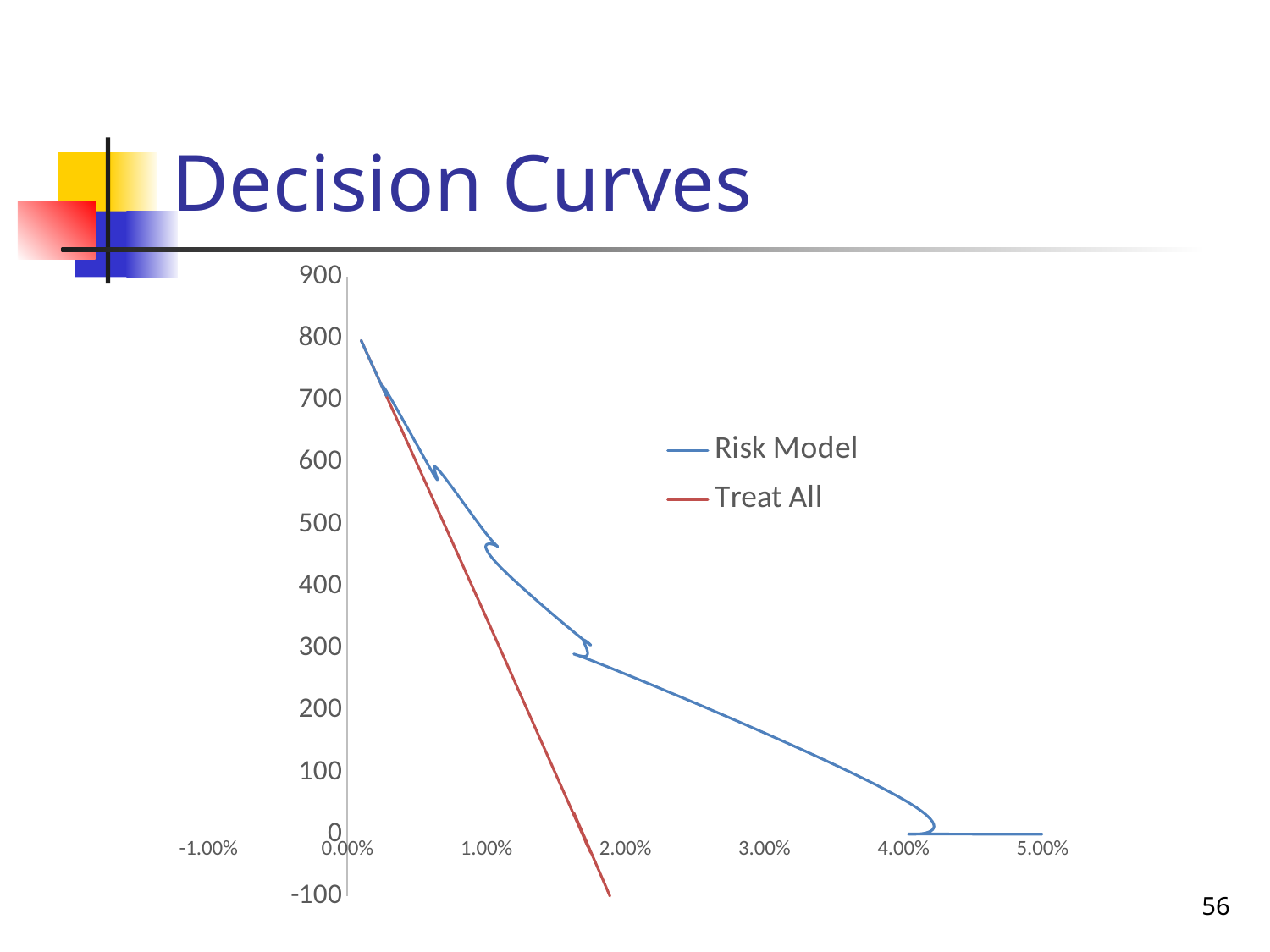
Do the Risk Model values rise or fall as the x-axis value increases? fall What is the title of the chart? Decision Curves Is the Risk Model value at 3.00% greater or less than 300? less At 3.00%, which series has the higher value, Risk Model or Treat All? Risk Model What kind of chart is shown on the slide? line chart Is the Treat All value at 1.00% greater or less than 400? less Is the Treat All value at 0.50% greater or less than 500? greater How many series does the legend list? 2 What colour is the Treat All line? red Do the Treat All values rise or fall as the x-axis value increases? fall